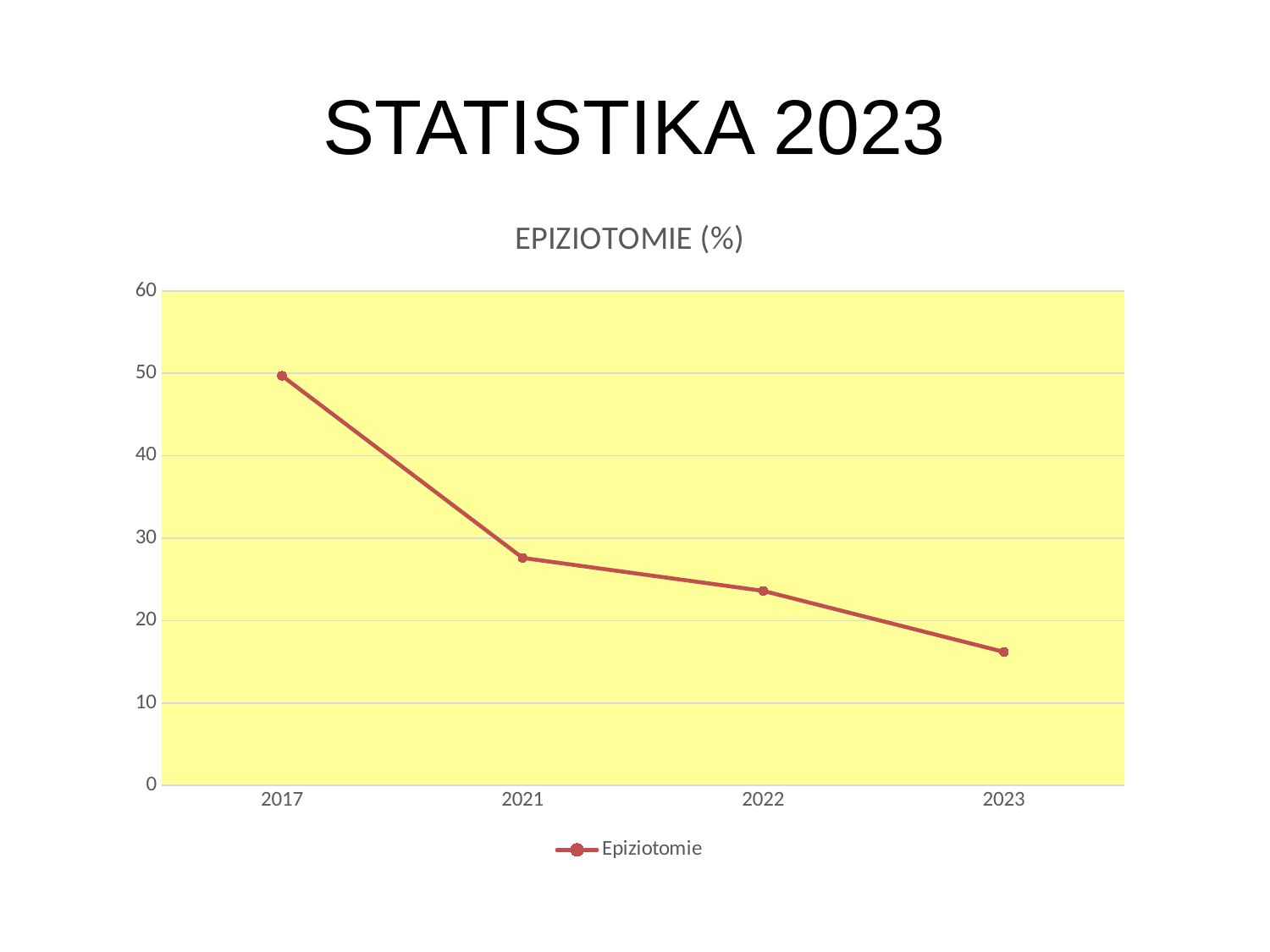
Is the value for 2022 greater or less than 20? greater What type of chart is shown on the slide? line chart Which is larger, the value for 2021 or the value for 2023? 2021 What is the title of the chart? EPIZIOTOMIE (%) Which year has the lowest value? 2023 Is the value for 2017 greater or less than 40? greater How many data points are plotted on the line? 4 Is the value for 2023 greater or less than 20? less How many series does the legend list? 1 Do the values rise or fall from 2017 to 2023? fall Which year has the highest value? 2017